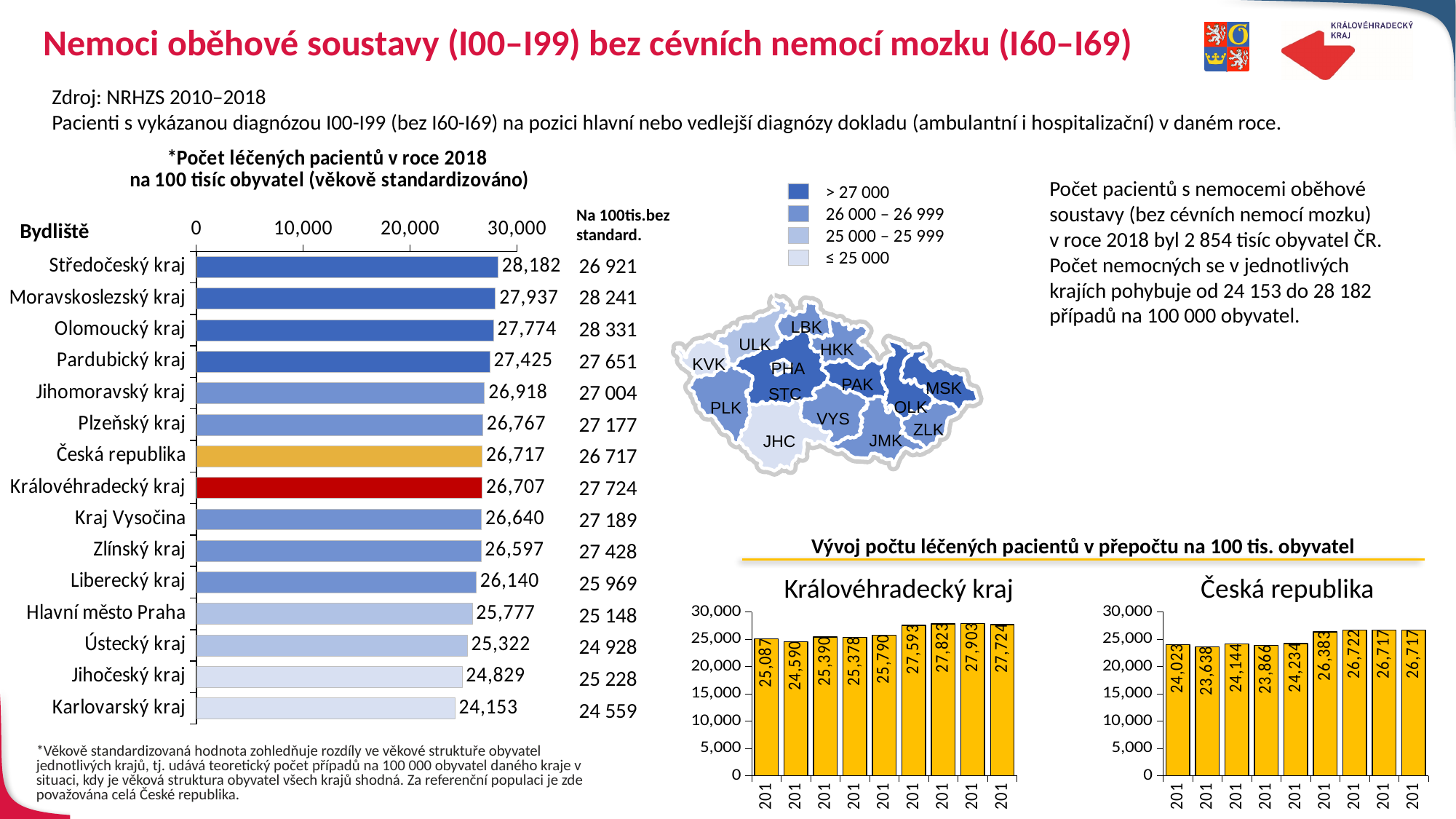
In the left bar chart (Počet léčených pacientů v roce 2018), what is the difference between the values for Středočeský kraj and Karlovarský kraj? 4,029 In the left bar chart (Počet léčených pacientů v roce 2018), what is the value for Středočeský kraj? 28,182 In the left bar chart (Počet léčených pacientů v roce 2018), which region's bar is coloured red? Královéhradecký kraj In the left bar chart (Počet léčených pacientů v roce 2018), which region has the lowest value? Karlovarský kraj In the bottom-right chart titled Královéhradecký kraj, what is the value of the last (rightmost) bar? 27,724 How many categories (rows) are plotted in the left bar chart (Počet léčených pacientů v roce 2018)? 15 In the left bar chart (Počet léčených pacientů v roce 2018), which region has the highest value? Středočeský kraj In the bottom-right chart titled Královéhradecký kraj, what is the highest value shown? 27,903 In the bottom-right chart titled Česká republika, what is the value of the first (leftmost) bar? 24,023 What kind of chart is the left chart titled Počet léčených pacientů v roce 2018? bar chart In the left bar chart (Počet léčených pacientů v roce 2018), which has the larger value: Pardubický kraj or Jihomoravský kraj? Pardubický kraj In the bottom-right chart titled Česká republika, do the values overall rise or fall from left to right? rise